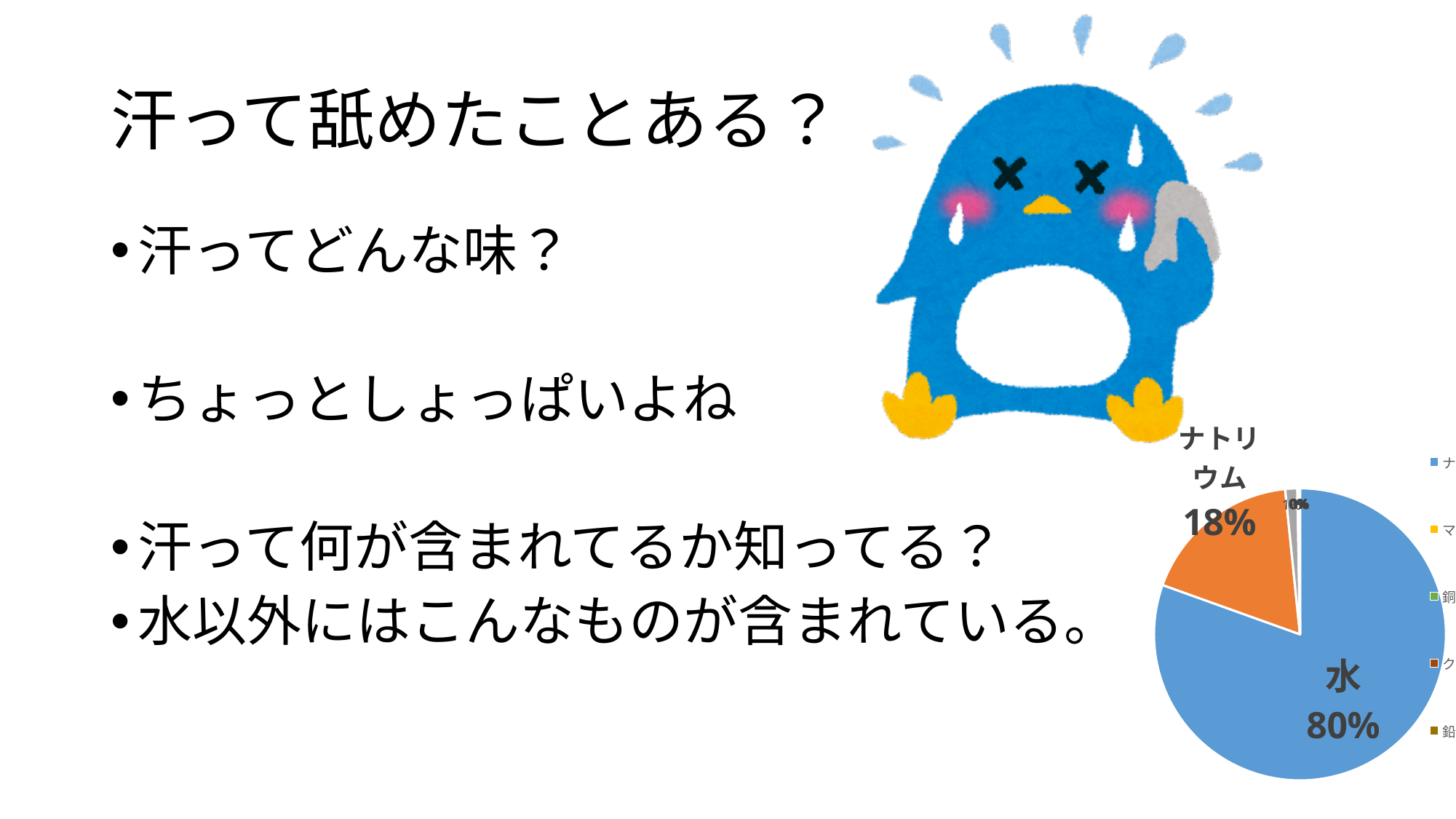
What share of the pie does 水 account for? 80% What do the 水 and ナトリウム slices add up to? 98% Is the share for ナトリウム greater or less than 20%? less What kind of chart is shown on the slide? pie chart What is the difference in percentage points between the 水 slice and the ナトリウム slice? 62% What share of the pie does ナトリウム account for? 18% Which category has the largest slice of the pie? 水 What colour is the ナトリウム slice of the pie? orange Which is larger, the slice for 水 or the slice for ナトリウム? 水 Is the share for 水 greater or less than 50%? greater What colour is the 水 slice of the pie? blue